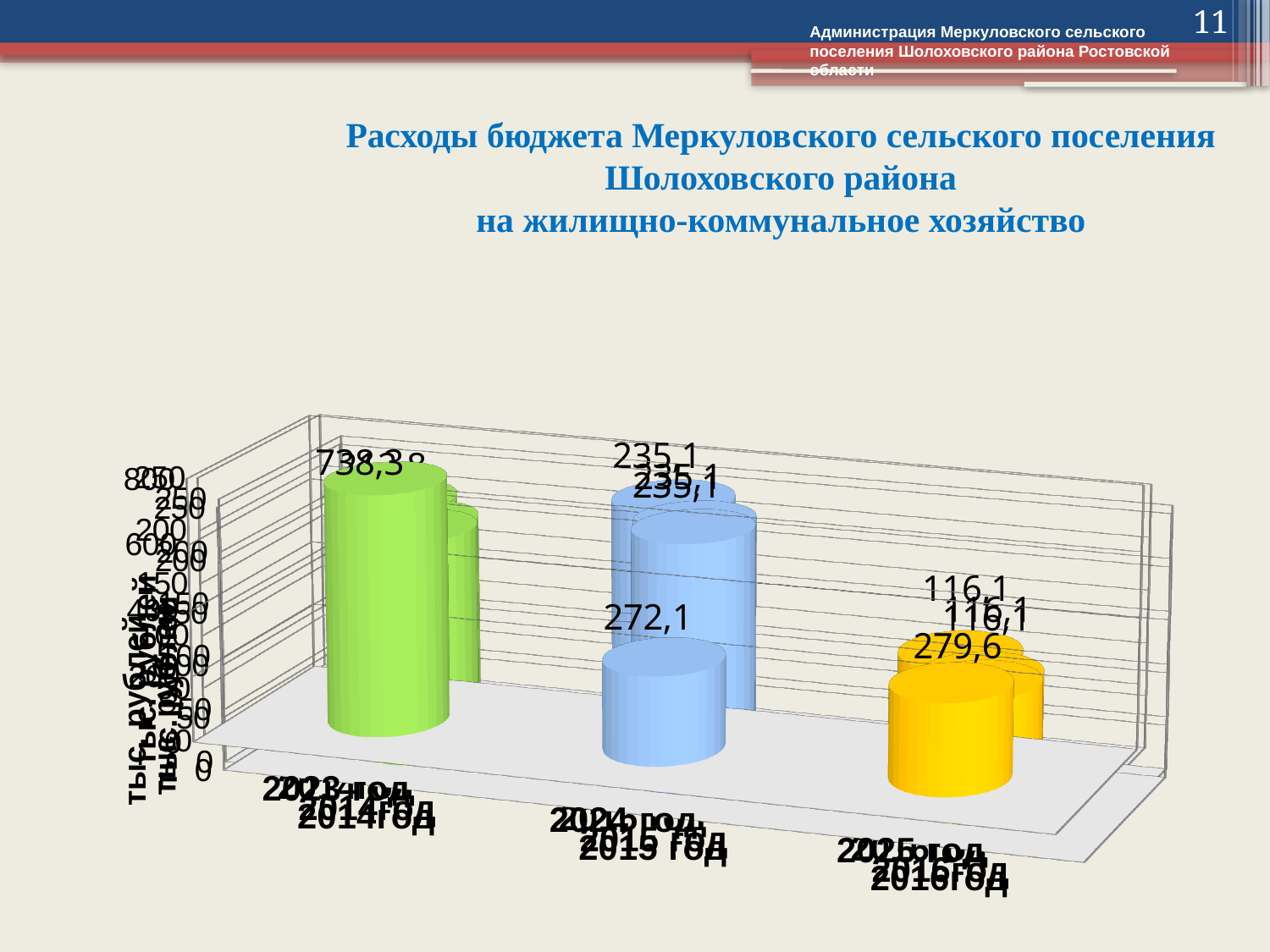
What value is printed on the large green cylinder at the front left of the chart? 738,3 What value is printed on the yellow cylinder at the front of the right-hand group? 279,6 What unit is written along the vertical axis of the chart? тыс. рублей How many category groups of cylinders are shown along the x axis of the chart? 3 What is the difference between the front green cylinder value (738,3) and the front blue cylinder value (272,1)? 466,2 What kind of chart is shown on the slide? bar chart What is the title of the chart on the slide? Расходы бюджета Меркуловского сельского поселения Шолоховского района на жилищно-коммунальное хозяйство Which colour of cylinder in the front row has the highest value? green What value is printed on the blue cylinder at the front of the middle group? 272,1 Which is larger, the front yellow cylinder value (279,6) or the front blue cylinder value (272,1)? 279,6 Which colour of cylinder in the front row has the lowest value? blue What is the difference between the front yellow cylinder value (279,6) and the front blue cylinder value (272,1)? 7,5